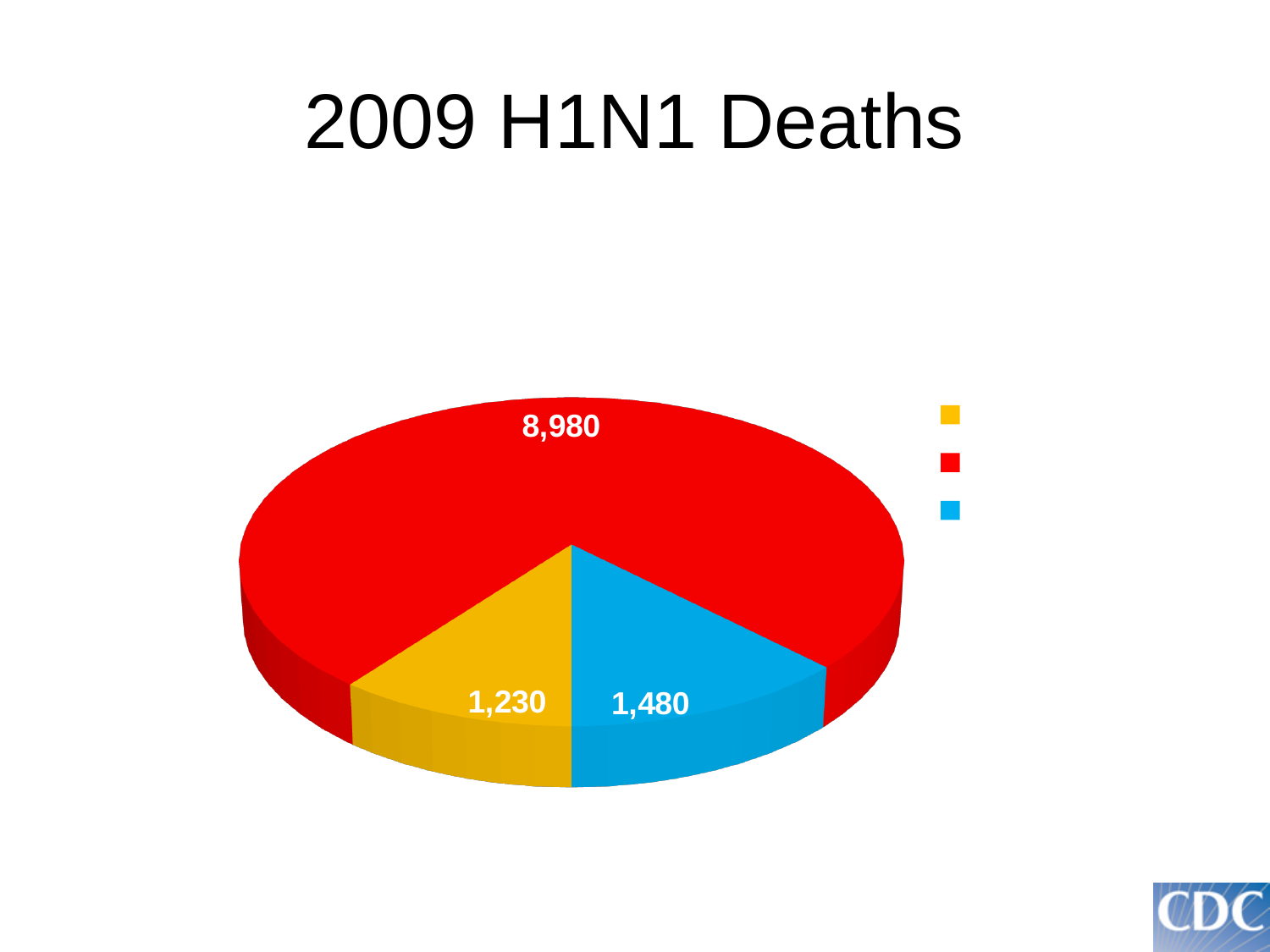
What value is shown on the red slice of the pie chart? 8,980 What is the title of the chart? 2009 H1N1 Deaths What value is shown on the yellow slice of the pie chart? 1,230 Which is larger, the blue slice value or the yellow slice value? the blue slice (1,480) What value is shown on the blue slice of the pie chart? 1,480 Which slice of the pie chart has the largest value? the red slice (8,980) What kind of chart is shown on the slide? pie chart How many slices does the pie chart have? 3 How many entries does the legend list? 3 What is the difference between the red slice value and the blue slice value? 7,500 What is the total of all three slice values in the pie chart? 11,690 Which slice of the pie chart has the smallest value? the yellow slice (1,230)